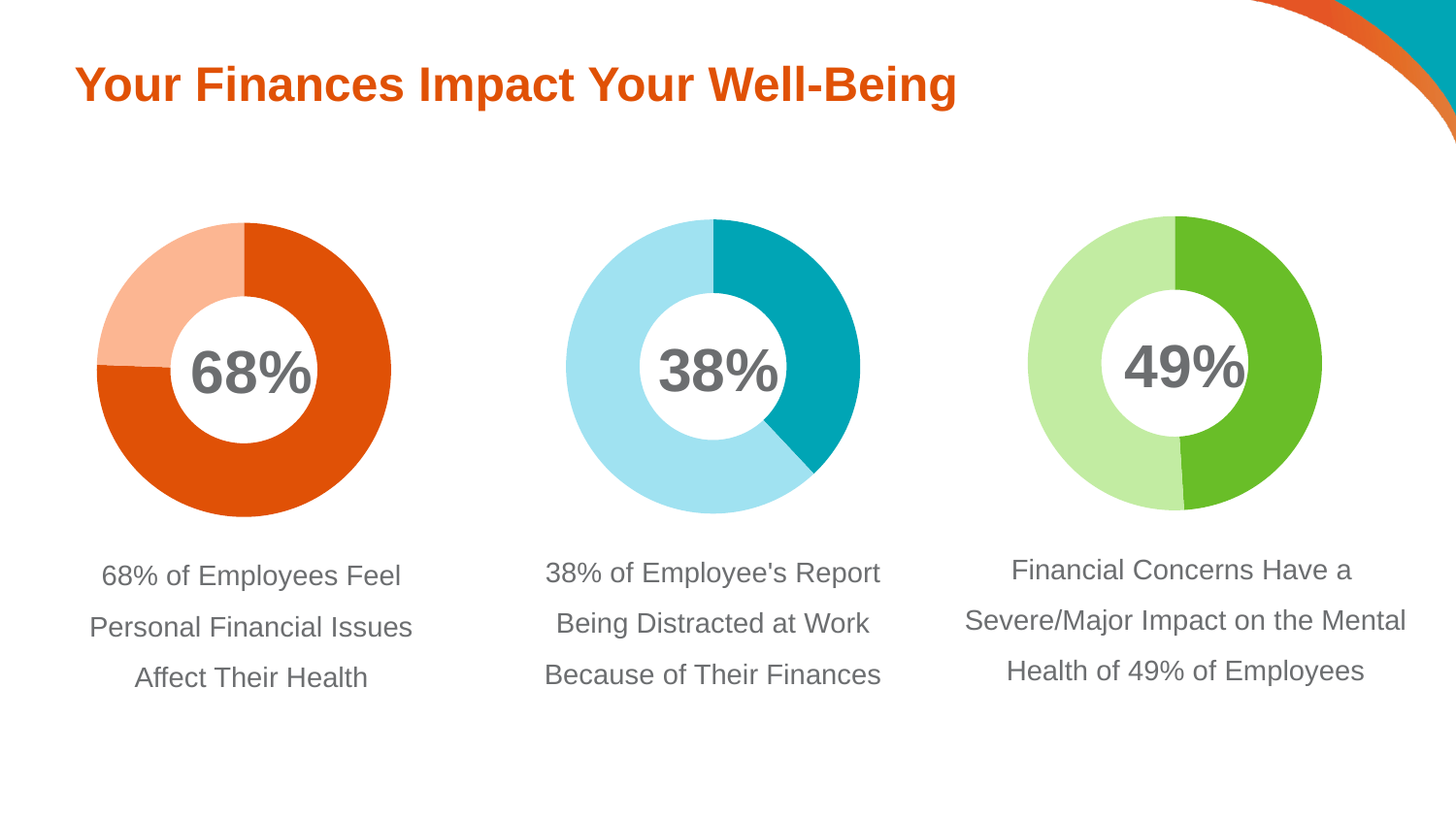
How many donut charts are on the slide? 3 What is the title of the slide? Your Finances Impact Your Well-Being What kind of charts are shown on the slide? Donut (pie) charts Which is larger: the percentage in the right (green) chart or the percentage in the middle (blue) chart? The right (green) chart, 49% What is the difference between the percentage in the left chart and the percentage in the middle chart? 30 percentage points What percentage is shown in the centre of the middle (blue) donut chart? 38% Which of the three donut charts shows the lowest percentage? The middle (blue) chart, 38% What percentage is shown in the centre of the right (green) donut chart? 49% Which of the three donut charts shows the highest percentage? The left (orange) chart, 68% What percentage is shown in the centre of the left (orange) donut chart? 68% What percentage of employees report being distracted at work because of their finances, according to the middle chart? 38%